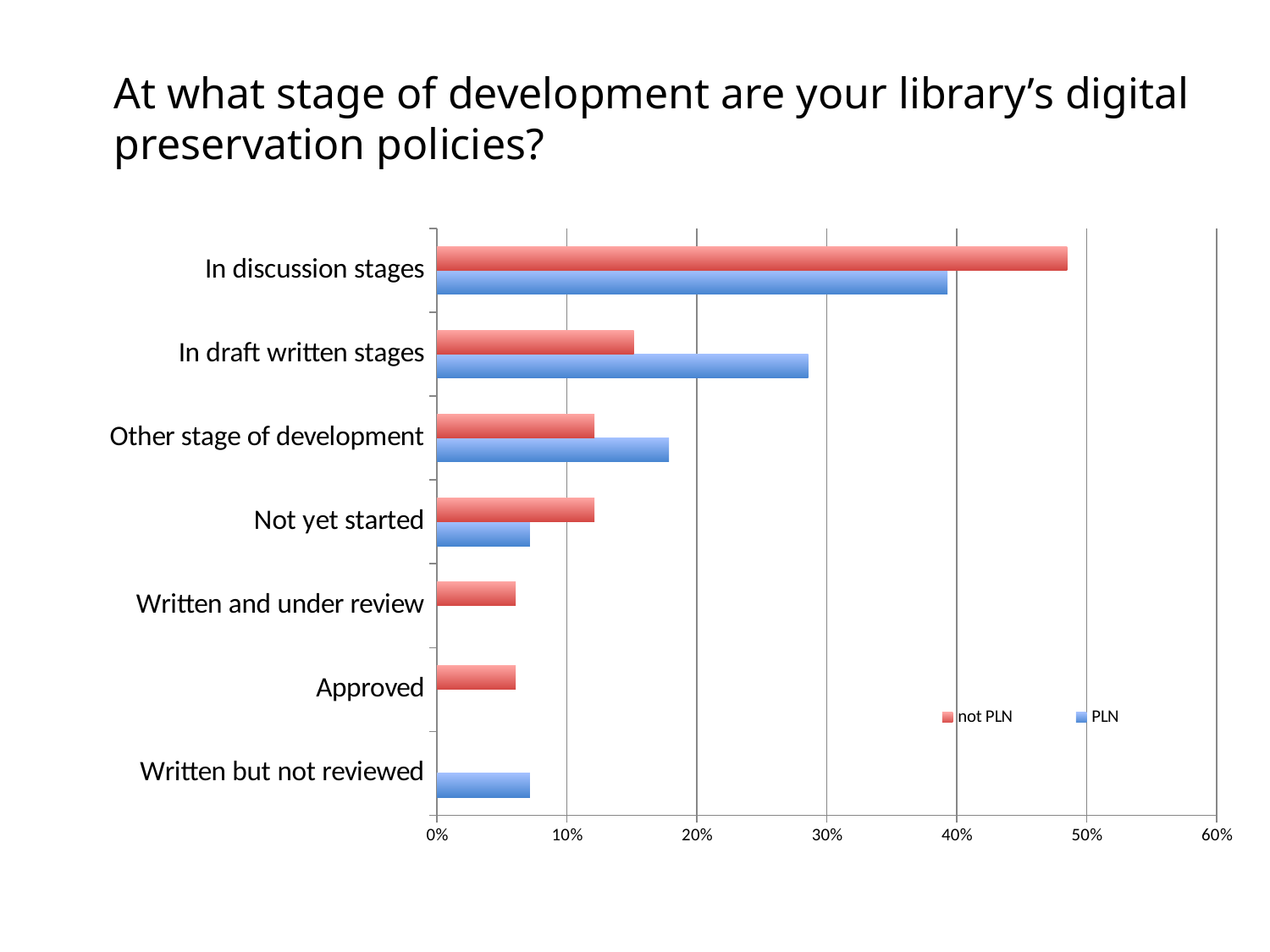
Is the PLN value for In draft written stages greater or less than 20%? greater What type of chart is shown on the slide? bar chart For Not yet started, which series has the larger value, not PLN or PLN? not PLN Is the not PLN value for Not yet started greater or less than 10%? greater Which category has the highest value for the PLN series? In discussion stages Which category has the highest value for the not PLN series? In discussion stages How many series does the legend list? 2 Is the not PLN value for In discussion stages greater or less than 40%? greater Which series is shown in blue according to the legend? PLN For In draft written stages, which series has the larger value, not PLN or PLN? PLN How many categories are shown on the chart? 7